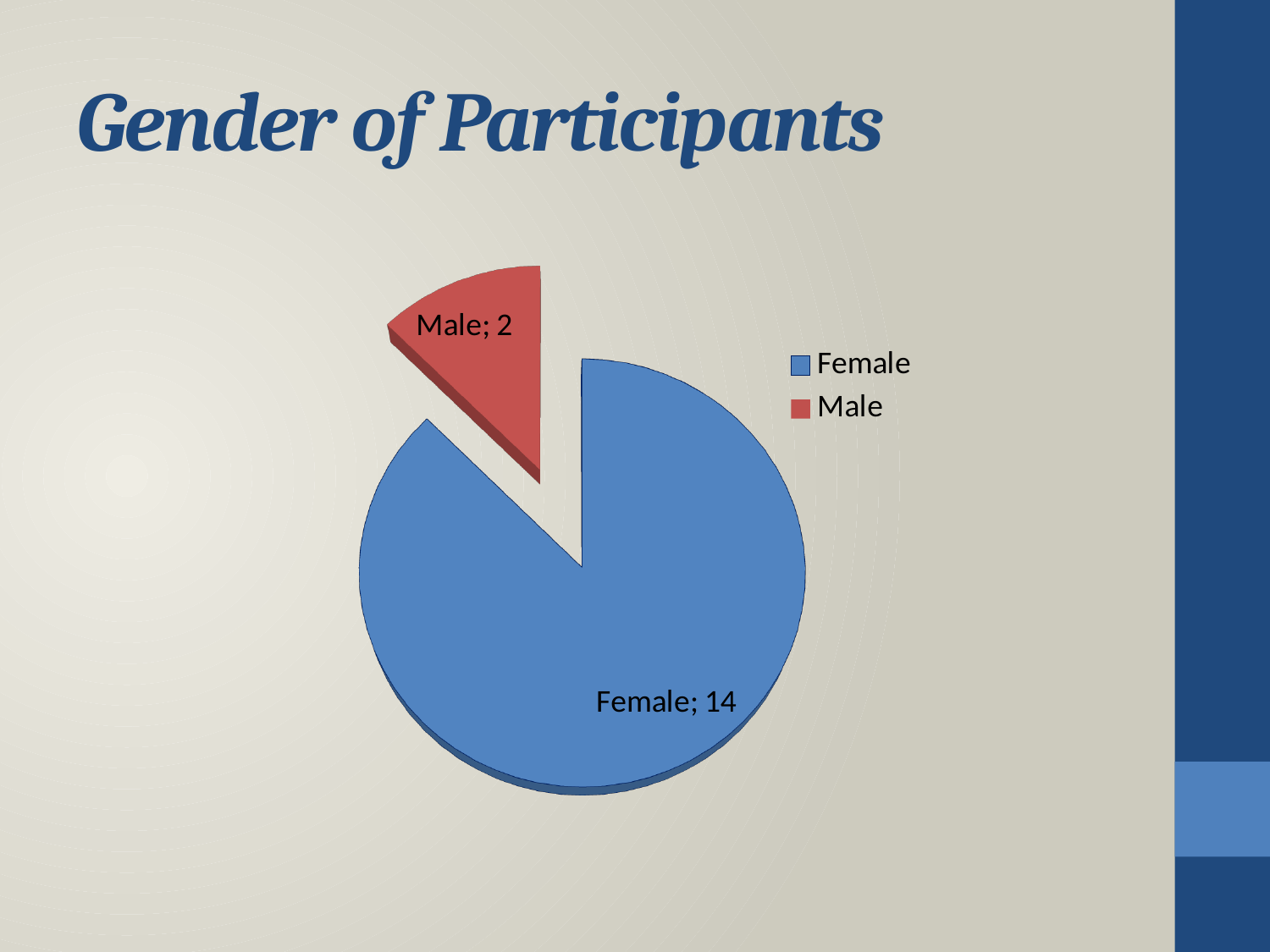
How many entries does the legend list? 2 How many categories are shown in the pie chart? 2 Which category has the largest slice of the pie? Female Which category has the smallest slice of the pie? Male What is the difference between the Female and Male values? 12 What share of the pie does the Male slice represent? 12.5% What is the value for Male in the pie chart? 2 What is the value for Female in the pie chart? 14 What is the total of all slices in the pie chart? 16 What is the title of the slide containing the chart? Gender of Participants Which is larger, the value for Female or the value for Male? Female What kind of chart is shown on the slide? Pie chart